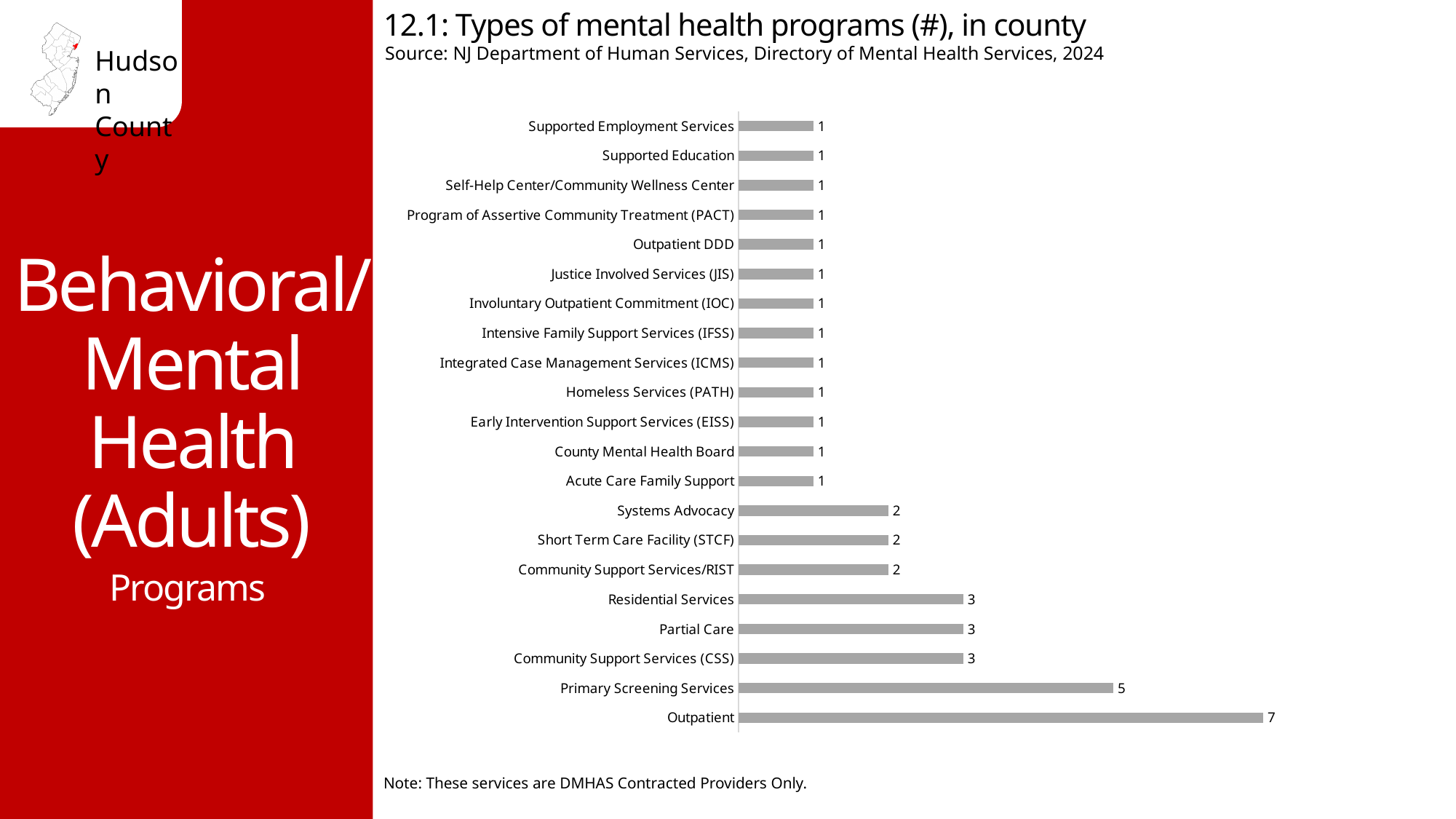
What is the difference between the values for Partial Care and Short Term Care Facility (STCF)? 1 What is the value for Systems Advocacy? 2 Which has a larger value, Community Support Services (CSS) or Community Support Services/RIST? Community Support Services (CSS) What is the difference between the values for Outpatient and Primary Screening Services? 2 What type of chart is shown on the slide? bar chart What is the value for Residential Services? 3 What is the value for Primary Screening Services? 5 What is the value for Homeless Services (PATH)? 1 What is the title of the chart? 12.1: Types of mental health programs (#), in county How many program types are listed in the chart? 21 How many mental health programs are there for Outpatient? 7 Which program type has the highest number of programs? Outpatient